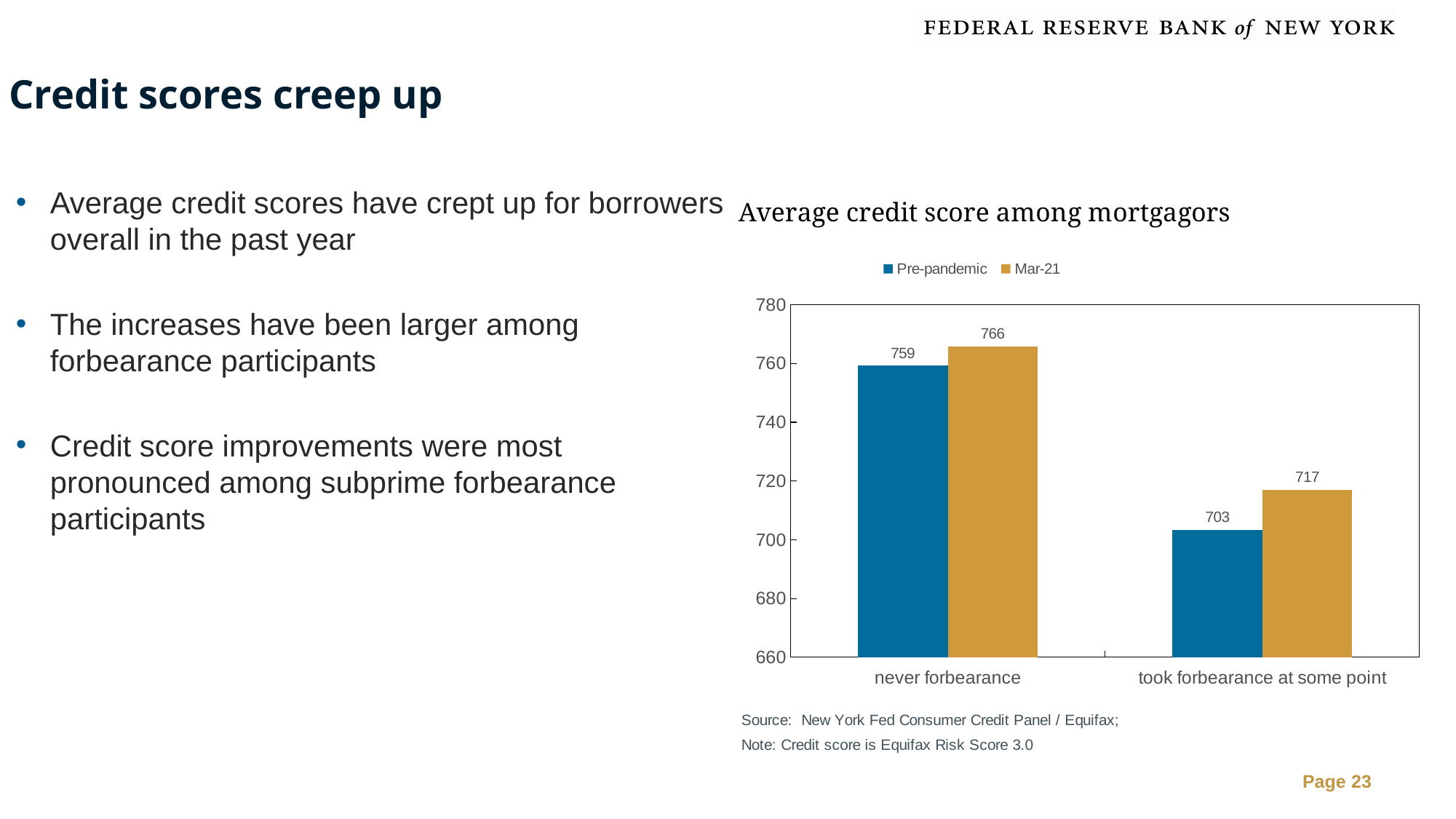
By how much did the average credit score rise from Pre-pandemic to Mar-21 for the 'took forbearance at some point' group? 14 How many series does the legend list? 2 What kind of chart is shown on the slide? bar chart What is the Pre-pandemic average credit score for the 'took forbearance at some point' group? 703 What is the title of the chart? Average credit score among mortgagors Which category has the lowest Pre-pandemic average credit score? took forbearance at some point Which is larger: the Pre-pandemic score for 'never forbearance' or the Mar-21 score for 'took forbearance at some point'? Pre-pandemic score for never forbearance What is the Pre-pandemic average credit score for the 'never forbearance' group? 759 What is the Mar-21 average credit score for the 'took forbearance at some point' group? 717 What is the Mar-21 average credit score for the 'never forbearance' group? 766 Which category has the highest Mar-21 average credit score? never forbearance By how much did the average credit score rise from Pre-pandemic to Mar-21 for the 'never forbearance' group? 7